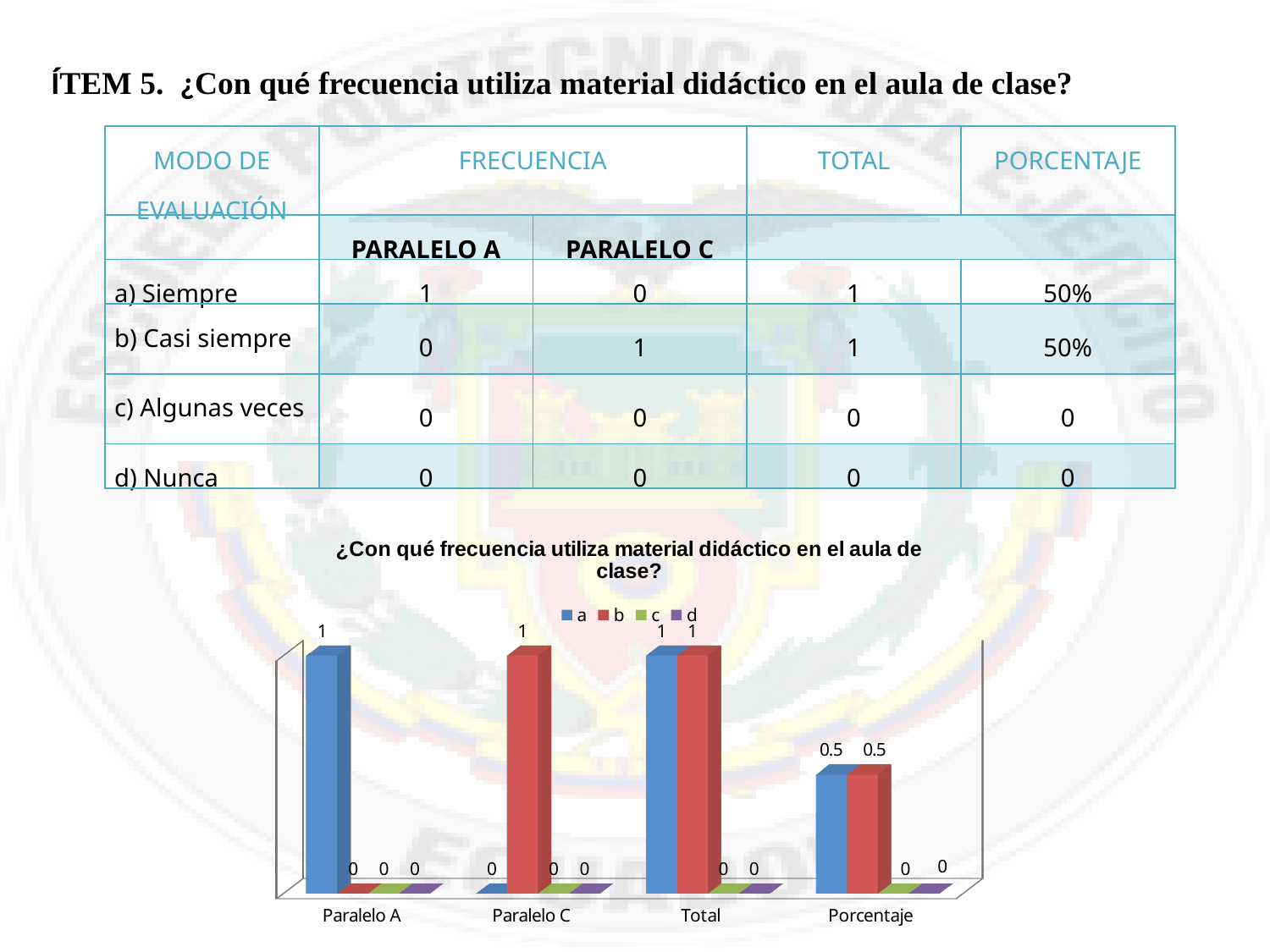
What is the value of series b for Paralelo C? 1 What is the difference between series a for Total and series a for Porcentaje? 0.5 What is the chart's title? ¿Con qué frecuencia utiliza material didáctico en el aula de clase? What type of chart is shown on the slide? bar chart What is the value of series b for Total? 1 How many series does the chart legend list? 4 Which series has the highest value for Paralelo A? a How many categories are shown on the x axis of the chart? 4 Which is larger for Paralelo C: series a or series b? b What is the value of series c for Total? 0 What is the value of series a for Paralelo A? 1 What is the value of series a for Porcentaje? 0.5